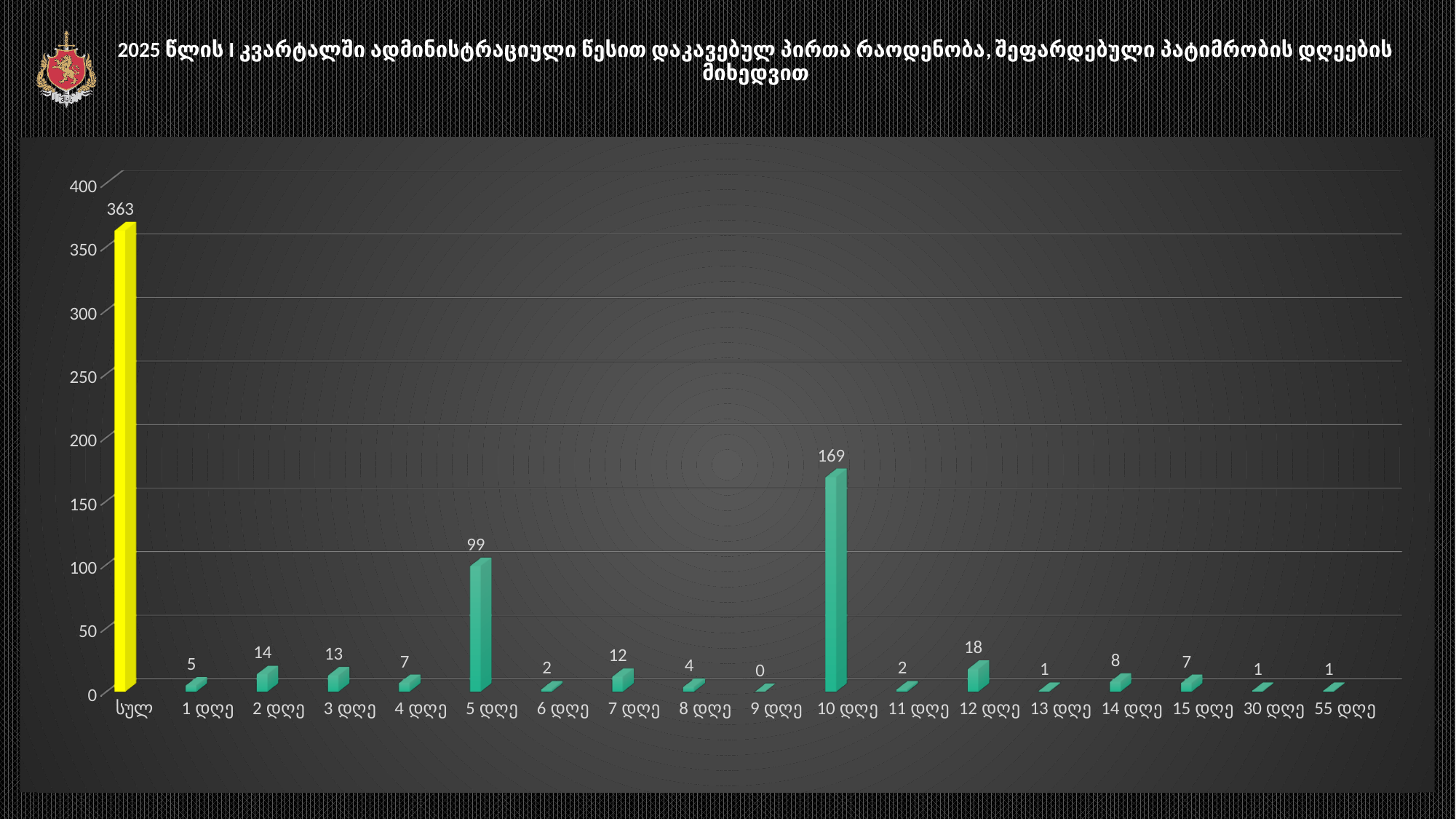
What is the value for "12 დღე"? 18 Is the value for "სულ" greater or less than 350? greater What colour is the "სულ" bar? yellow Which is larger, the value for "2 დღე" or the value for "3 დღე"? 2 დღე What is the value for "5 დღე"? 99 Excluding the "სულ" total bar, which day category has the highest value? 10 დღე What is the value for "10 დღე"? 169 Which category has the lowest value? 9 დღე What kind of chart is shown on the slide? bar chart What is the value for the "სულ" bar? 363 How many categories are shown on the x axis? 18 What is the difference between the values for "10 დღე" and "5 დღე"? 70